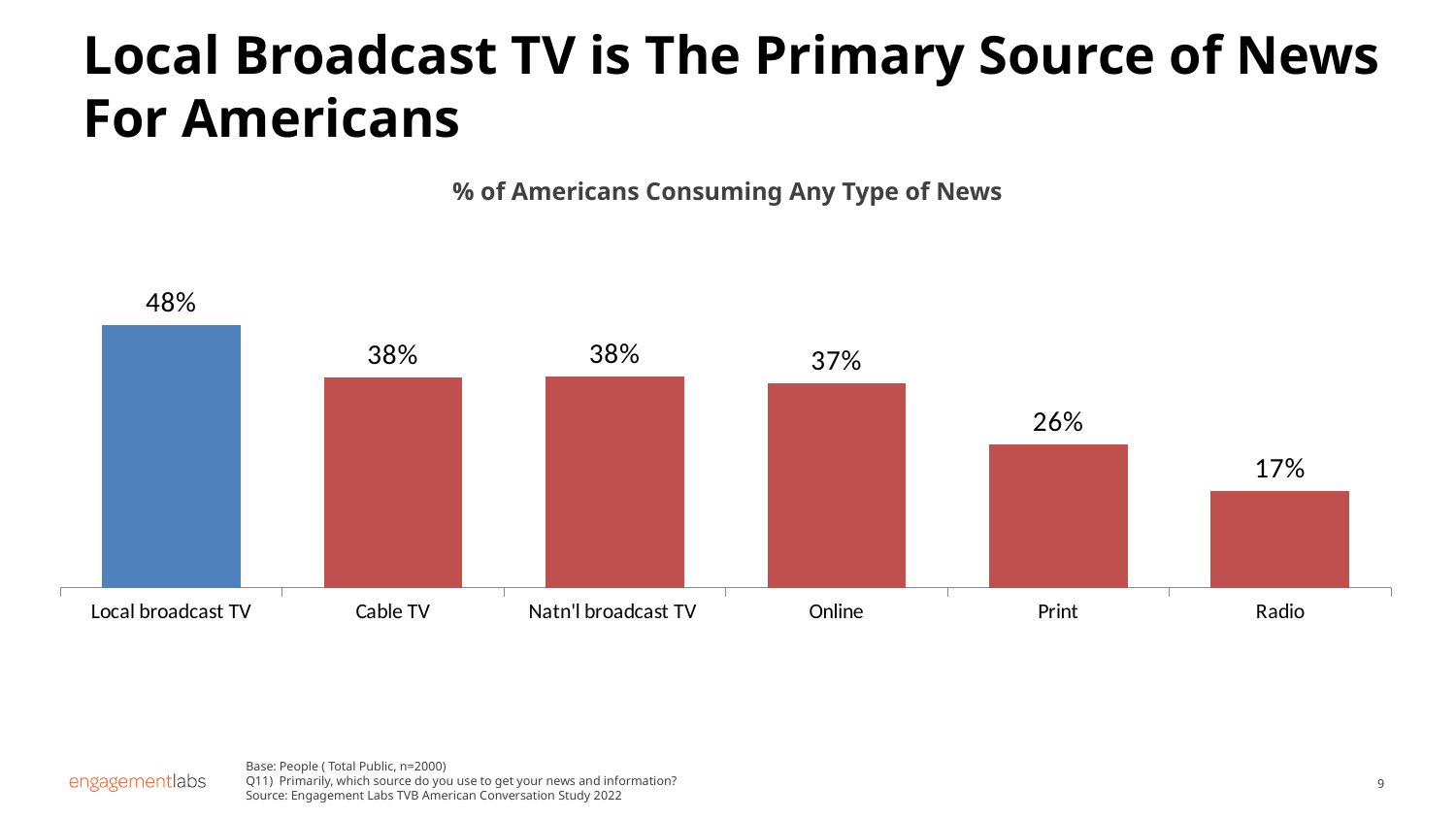
Which is larger, the value for Online or the value for Print? Online What is the value shown for Print? 26% How many news sources are shown in the chart? 6 Do the values rise or fall moving from left to right across the chart? Fall Which news source has the lowest percentage? Radio Which news source has the highest percentage? Local broadcast TV What percentage of Americans consume news from Local broadcast TV? 48% What is the value shown for Online? 37% What is the title of the chart? % of Americans Consuming Any Type of News What is the difference between the values for Local broadcast TV and Radio? 31% What kind of chart is shown on the slide? Bar chart What is the difference between the values for Cable TV and Print? 12%